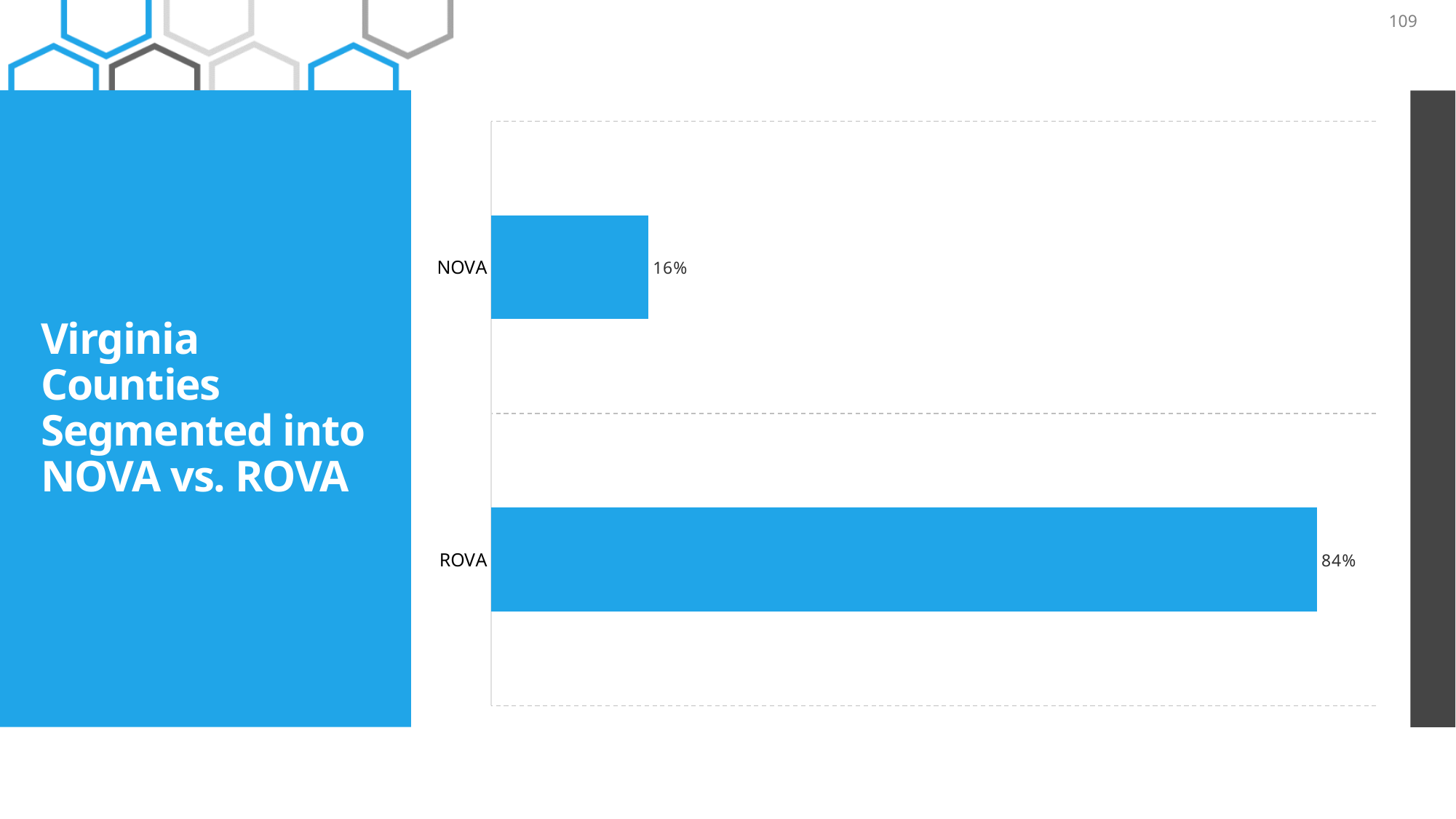
Which category has the highest value? ROVA What is the value for ROVA? 84% Which is larger, the value for NOVA or the value for ROVA? ROVA What is the title of the slide containing the chart? Virginia Counties Segmented into NOVA vs. ROVA Which category has the lowest value? NOVA How many categories are shown in the chart? 2 What kind of chart is shown on the slide? Bar chart What is the total of the two values shown in the chart? 100% What colour are the bars in the chart? Blue What is the value for NOVA? 16% What is the difference between the values for ROVA and NOVA? 68%